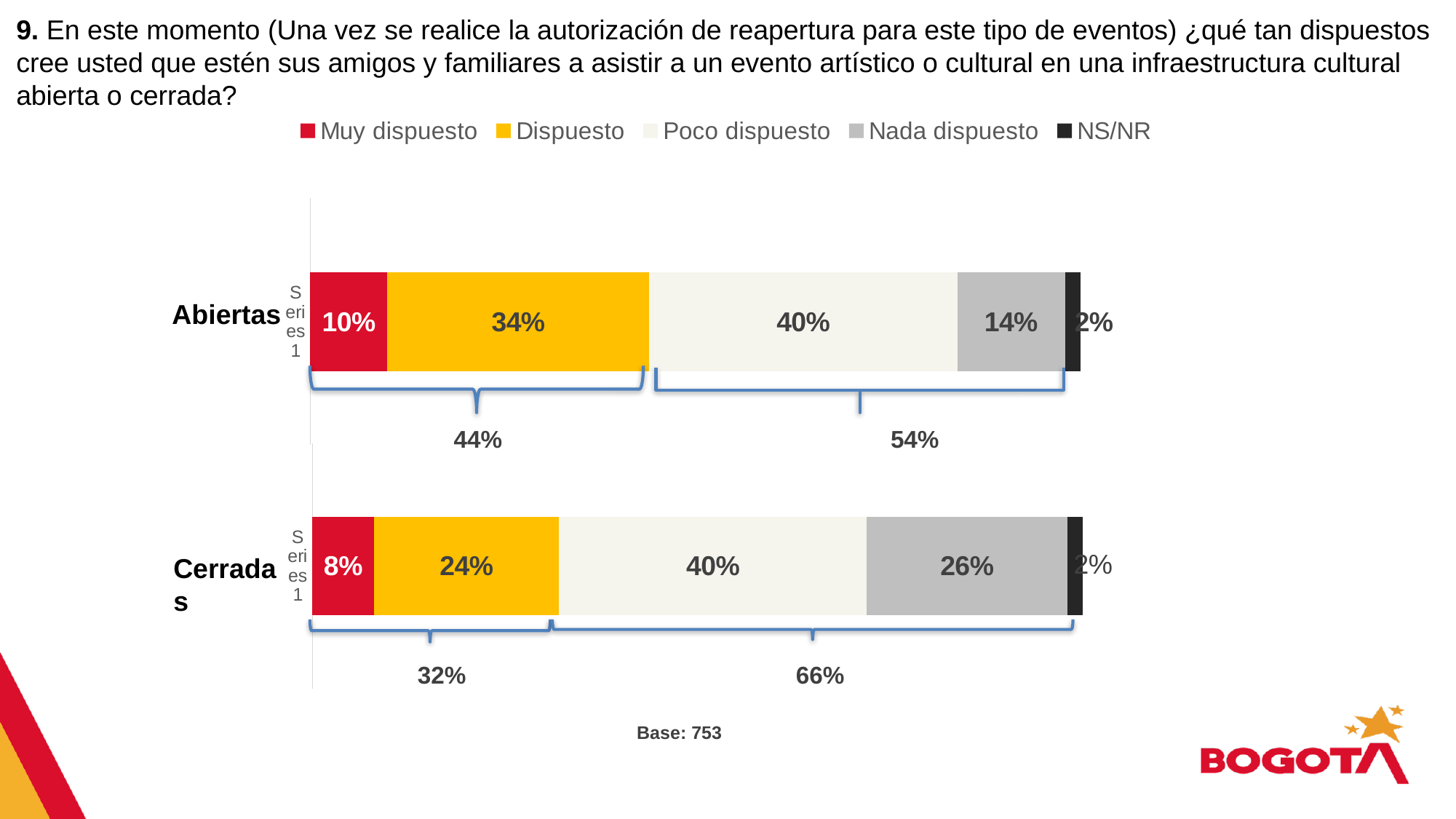
What percentage of respondents said 'Muy dispuesto' for Abiertas? 10% Which response category has the smallest share in the Cerradas bar? NS/NR What is the combined share of 'Muy dispuesto' and 'Dispuesto' for Abiertas, as shown by the bracket label? 44% What is the 'Poco dispuesto' value for the Abiertas bar? 40% Which response category has the largest share in the Abiertas bar? Poco dispuesto How many series does the legend list? 5 Which bar has a larger 'Dispuesto' share, Abiertas or Cerradas? Abiertas What is the 'Dispuesto' value for the Cerradas bar? 24% What is the combined share of 'Poco dispuesto', 'Nada dispuesto' and 'NS/NR' for Cerradas, as shown by the bracket label? 66% What percentage of respondents said 'Nada dispuesto' for Cerradas? 26% What is the difference between the 'Nada dispuesto' values for Cerradas and Abiertas? 12% What type of chart is shown on the slide? Stacked bar chart